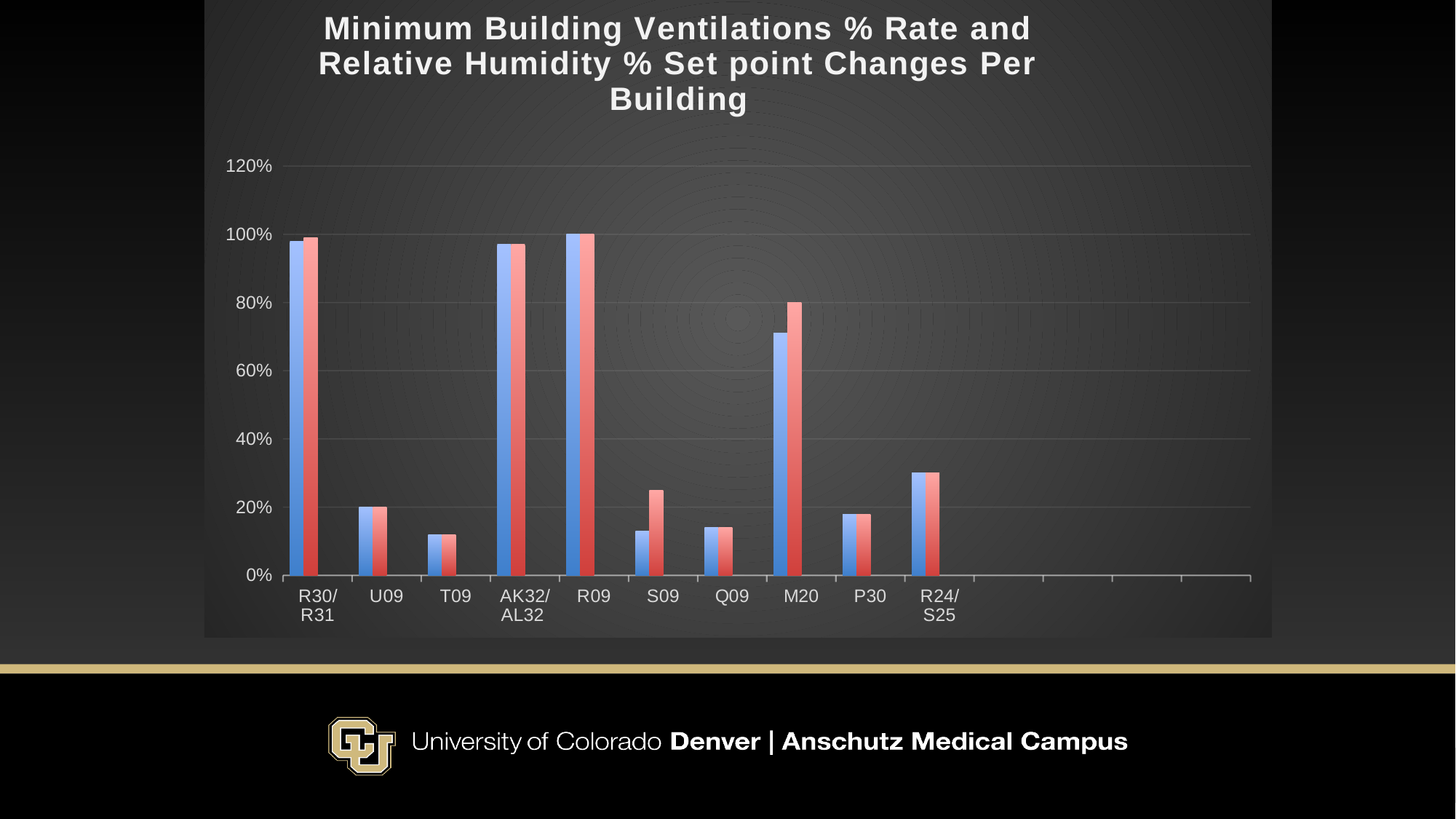
Is the value for P30 greater or less than 20%? less Is the value for T09 greater or less than 20%? less Which building has the larger value, U09 or T09? U09 What kind of chart is shown on the slide? bar chart Is the value for AK32/AL32 greater or less than 80%? greater Which building has the larger value, M20 or R24/S25? M20 What two colours are used for the bars in the chart? blue and red How many buildings (categories) are shown on the x axis of the chart? 10 What is the title of the chart? Minimum Building Ventilations % Rate and Relative Humidity % Set point Changes Per Building